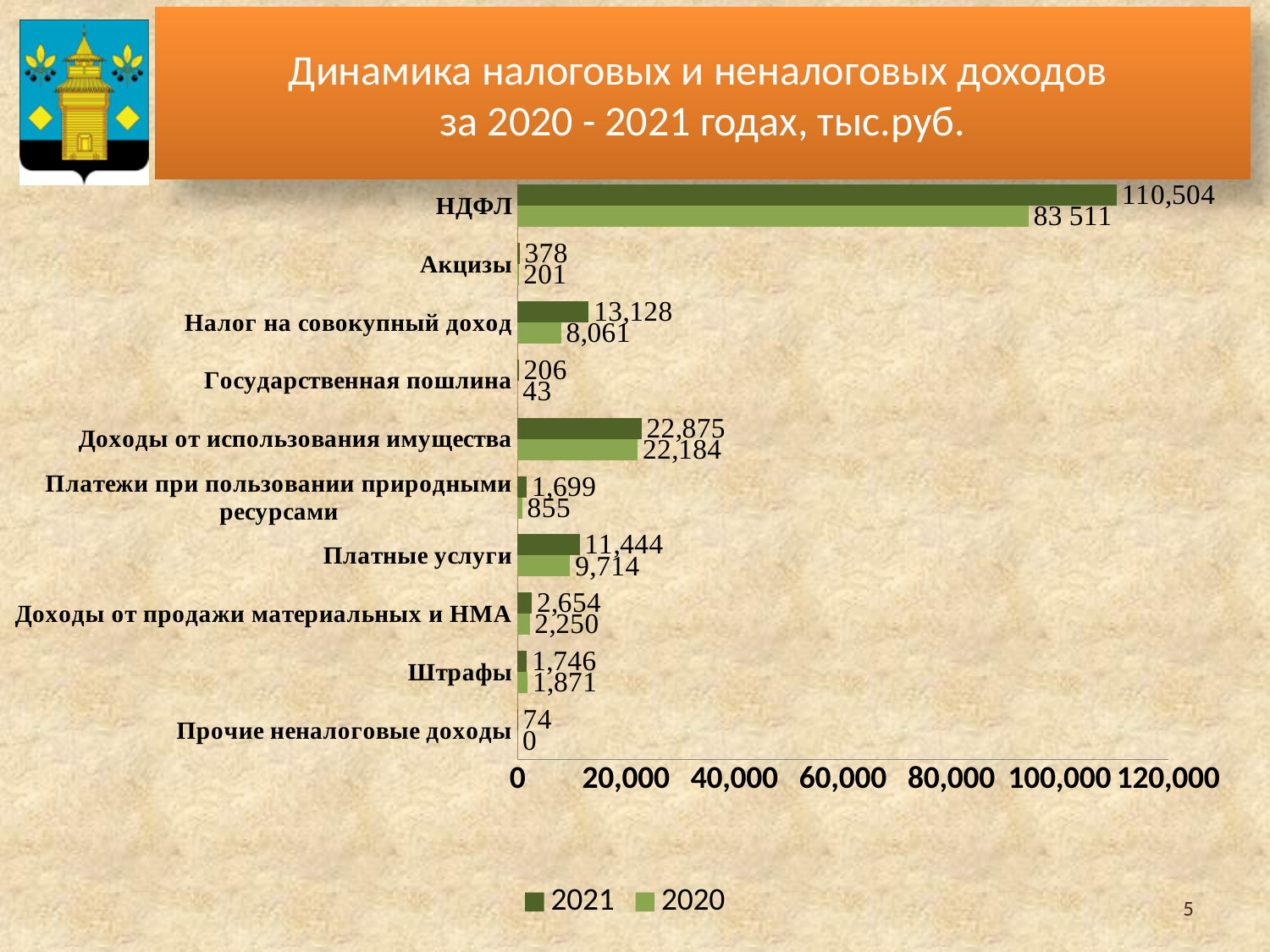
What is the difference between the 2021 and 2020 values for Налог на совокупный доход? 5,067 For Штрафы, which year has the larger value, 2021 or 2020? 2020 What kind of chart is shown on the slide? Bar chart How many series does the legend list? 2 What is the 2020 value for НДФЛ? 83 511 Which category has the lowest 2020 value? Прочие неналоговые доходы What is the 2020 value for Платные услуги? 9,714 Which category has the highest 2021 value? НДФЛ Is the 2020 value for НДФЛ greater or less than 80,000? greater What is the 2021 value for НДФЛ? 110,504 How many categories are shown on the chart? 10 What is the 2021 value for Налог на совокупный доход? 13,128